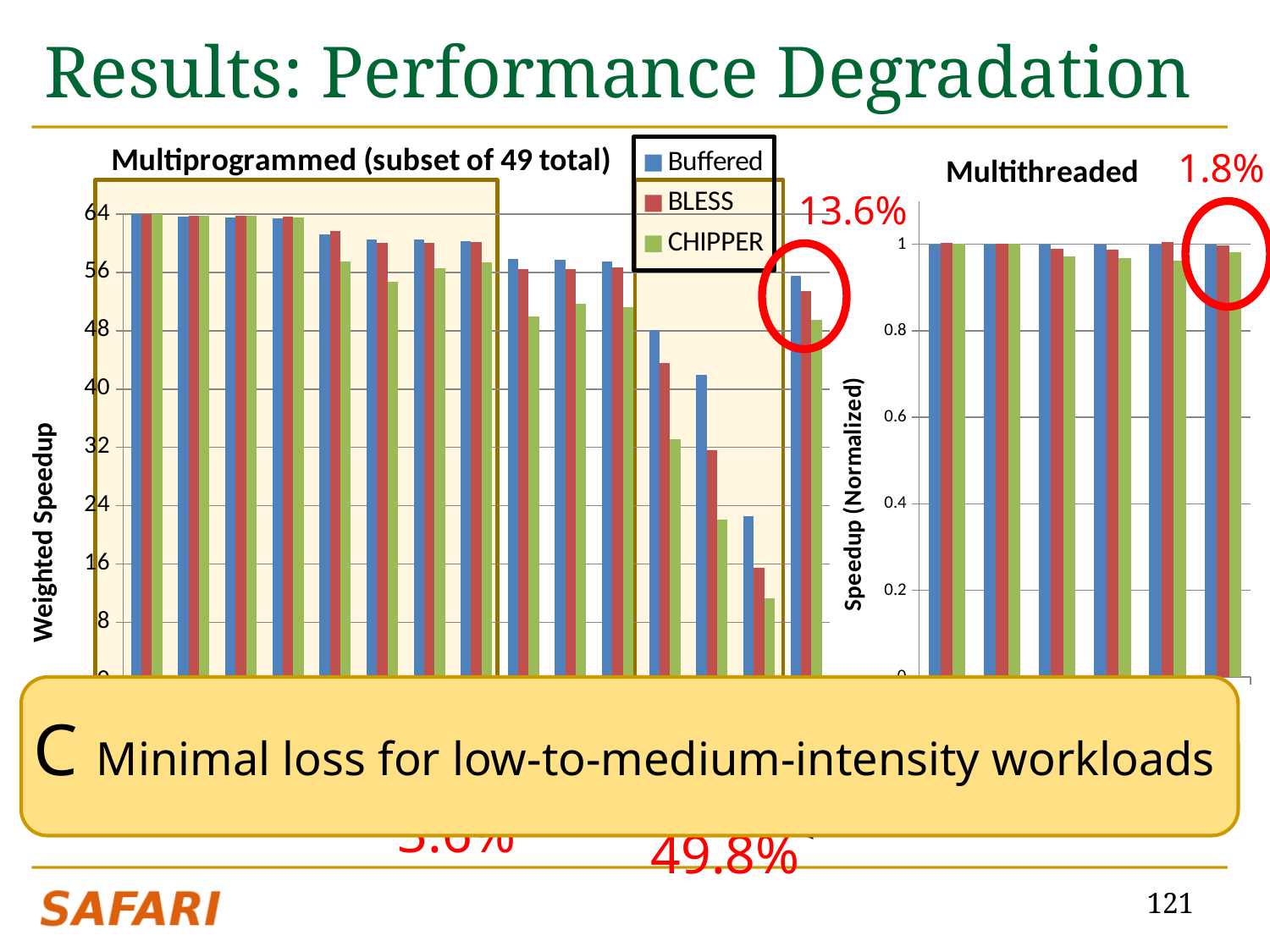
What is the y-axis title of the Multithreaded chart? Speedup (Normalized) How many groups of bars are plotted in the Multithreaded chart? 6 In the Multiprogrammed (subset of 49 total) chart, is the Buffered value for the first group of bars greater or less than 56? greater In the Multiprogrammed (subset of 49 total) chart, is the CHIPPER value in the group with the lowest bars greater or less than 16? less What kind of chart is the Multiprogrammed (subset of 49 total) chart? bar chart What is the highest tick value shown on the y-axis of the Multiprogrammed (subset of 49 total) chart? 64 In the Multiprogrammed (subset of 49 total) chart, which series has the tallest bar in the group with the lowest values? Buffered What percentage is annotated next to the red circle on the Multithreaded chart? 1.8% Which series are listed in the legend? Buffered, BLESS, CHIPPER How many series does the legend list? 3 How many groups of bars are plotted in the Multiprogrammed (subset of 49 total) chart? 15 In the Multithreaded chart, is the Buffered value for the first group of bars greater or less than 0.8? greater